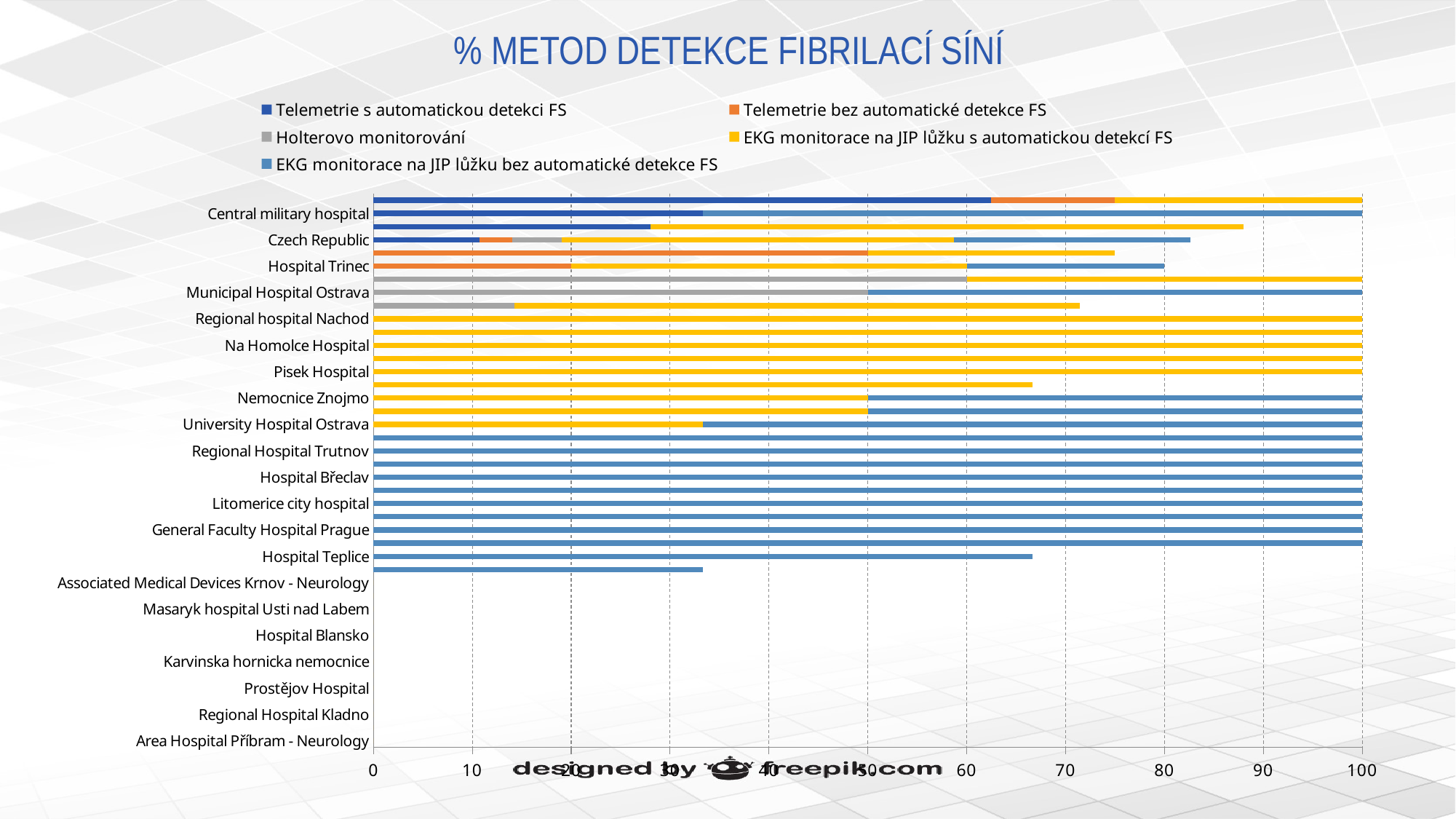
What is the value of 'EKG monitorace na JIP lůžku bez automatické detekce FS' for Hospital Trinec? 20 What is the value of 'EKG monitorace na JIP lůžku s automatickou detekcí FS' for Nemocnice Znojmo? 50 What colour represents 'Holterovo monitorování' in the legend? grey Which has the larger value for 'EKG monitorace na JIP lůžku bez automatické detekce FS': Hospital Trinec or Municipal Hospital Ostrava? Municipal Hospital Ostrava What is the title of the chart? % METOD DETEKCE FIBRILACÍ SÍNÍ What kind of chart is shown on the slide? bar chart Is the value of 'Telemetrie s automatickou detekci FS' for Czech Republic greater or less than 20? less What is the value of 'Holterovo monitorování' for Municipal Hospital Ostrava? 50 What is the value of 'Telemetrie bez automatické detekce FS' for Hospital Trinec? 20 How many series does the legend list? 5 What is the value of 'EKG monitorace na JIP lůžku s automatickou detekcí FS' for Regional hospital Nachod? 100 Is the value of 'EKG monitorace na JIP lůžku bez automatické detekce FS' for Hospital Teplice greater or less than 60? greater